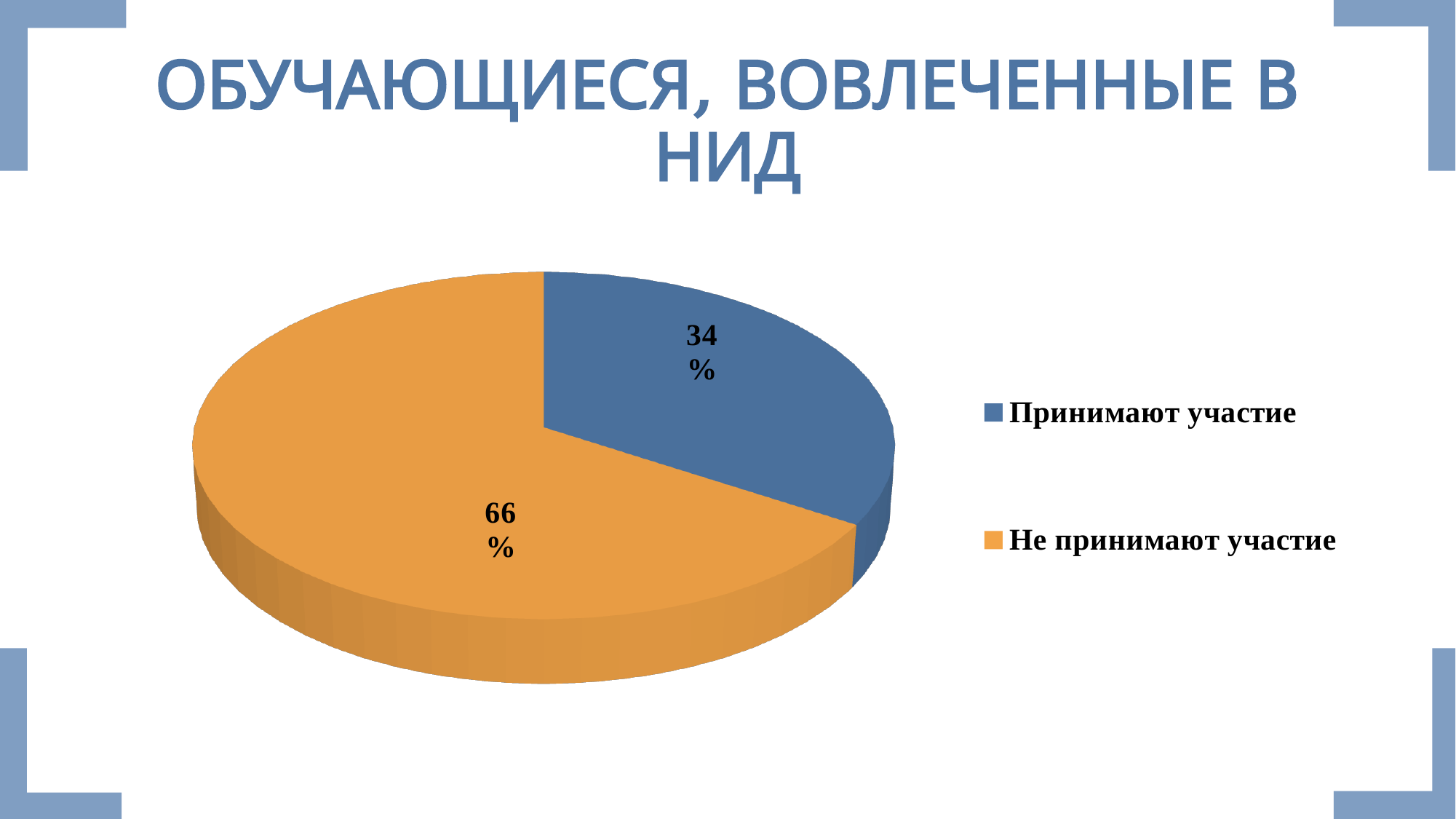
What colour is the slice for "Принимают участие"? Blue Which category has the largest slice of the pie? Не принимают участие What share of the pie does "Принимают участие" represent? 34% How many slices does the pie chart have? 2 What kind of chart is shown on the slide? Pie chart What share of the pie does "Не принимают участие" represent? 66% What is the title of the slide? ОБУЧАЮЩИЕСЯ, ВОВЛЕЧЕННЫЕ В НИД What is the difference in percentage points between "Не принимают участие" and "Принимают участие"? 32 Which is larger: the share for "Принимают участие" or for "Не принимают участие"? Не принимают участие How many entries does the legend list? 2 Which category has the smallest slice of the pie? Принимают участие